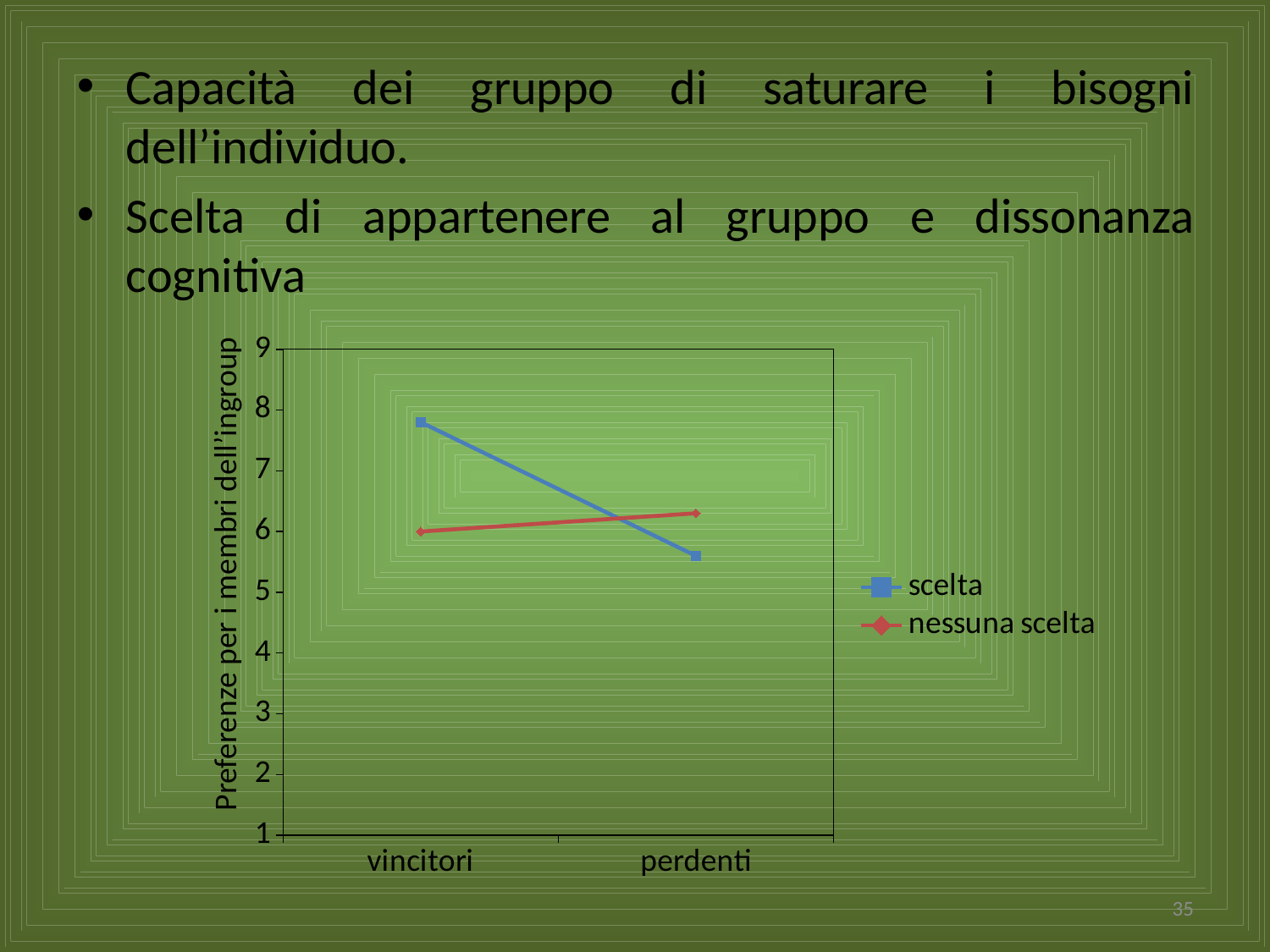
How many series does the legend list? 2 Does the 'nessuna scelta' series rise or fall from vincitori to perdenti? rise What kind of chart is shown on the slide? line chart Is the value for 'scelta' at vincitori greater or less than 7? greater Does the 'scelta' series rise or fall from vincitori to perdenti? fall How many categories are shown on the x axis? 2 Is the value for 'scelta' at perdenti greater or less than 6? less At perdenti, which series has the higher value, 'scelta' or 'nessuna scelta'? nessuna scelta At vincitori, which series has the higher value, 'scelta' or 'nessuna scelta'? scelta What are the two series named in the legend? scelta, nessuna scelta What is the label of the vertical axis? Preferenze per i membri dell'ingroup Is the value for 'nessuna scelta' at perdenti greater or less than 7? less